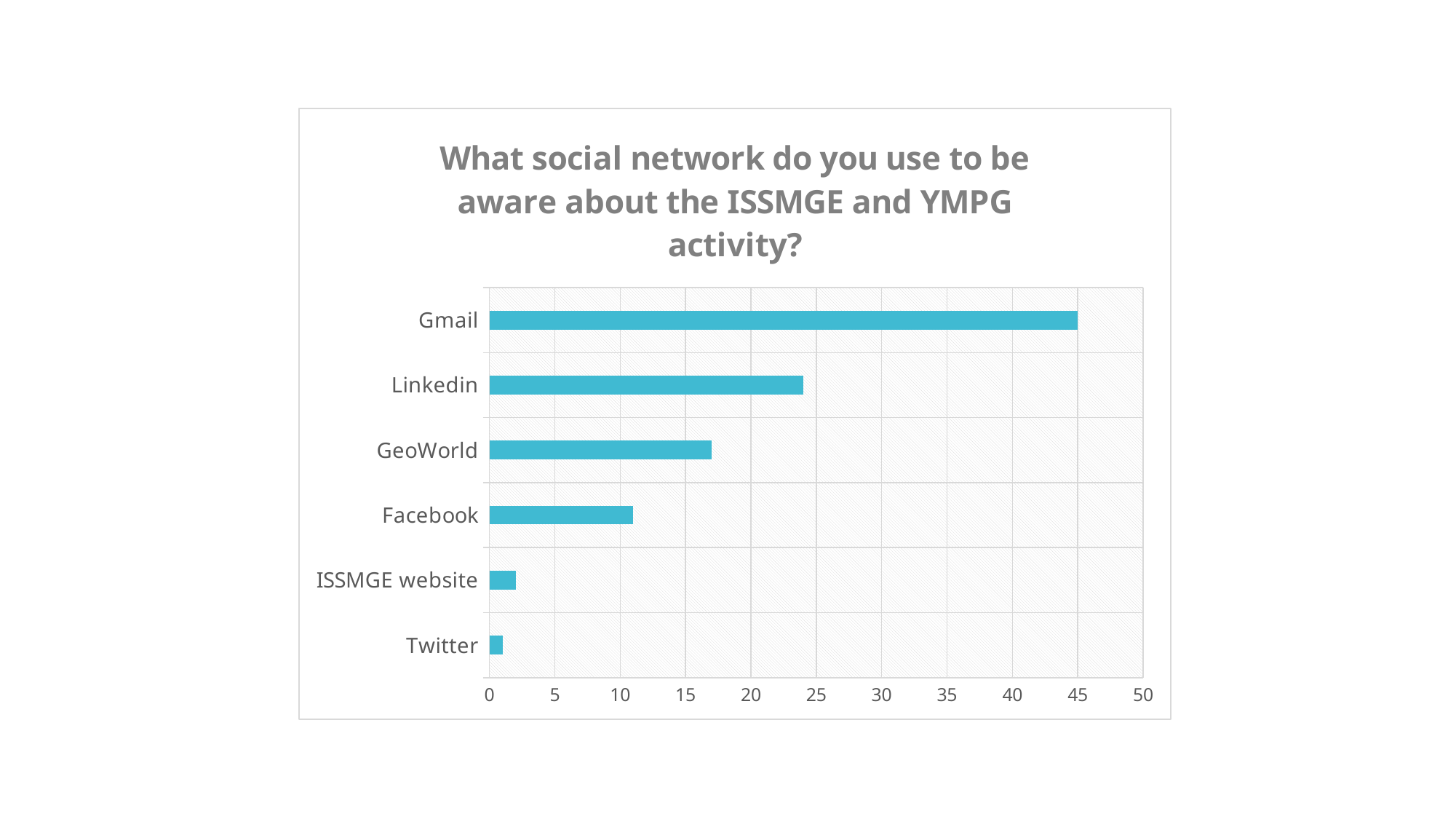
Is the value for GeoWorld greater or less than 20? less Is the value for ISSMGE website greater or less than 5? less Is the value for Facebook greater or less than 10? greater What is the value for Gmail? 45 How many categories are shown in the chart? 6 Which has a larger value, GeoWorld or ISSMGE website? GeoWorld Which category has the highest value? Gmail What is the title of the chart? What social network do you use to be aware about the ISSMGE and YMPG activity? Which has a larger value, Linkedin or Facebook? Linkedin Which category has the lowest value? Twitter What type of chart is shown on the slide? bar chart